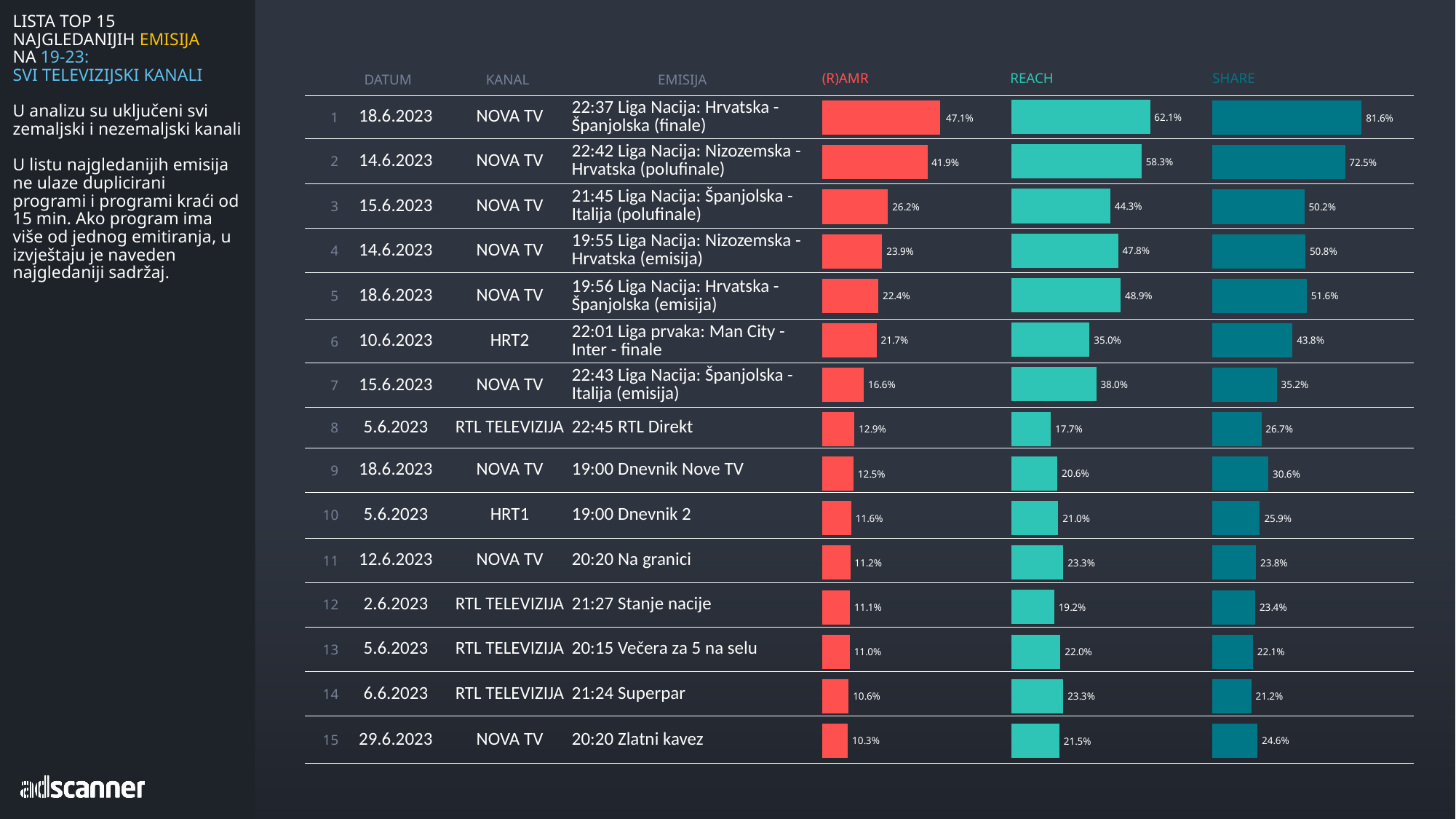
In the SHARE chart, what is the difference between 19:00 Dnevnik Nove TV and 19:00 Dnevnik 2? 4.7% In the REACH chart, which programme has the lowest value? 22:45 RTL Direkt In the (R)AMR chart, which programme has the lowest value? 20:20 Zlatni kavez In the (R)AMR chart, what is the value for 22:45 RTL Direkt? 12.9% What kind of chart is used for the REACH column? Bar chart In the SHARE chart, what is the value for 20:20 Zlatni kavez? 24.6% In the REACH chart, which is larger: 19:56 Liga Nacija: Hrvatska - Španjolska (emisija) or 19:55 Liga Nacija: Nizozemska - Hrvatska (emisija)? 19:56 Liga Nacija: Hrvatska - Španjolska (emisija) In the (R)AMR chart, what is the difference between 22:37 Liga Nacija: Hrvatska - Španjolska (finale) and 22:42 Liga Nacija: Nizozemska - Hrvatska (polufinale)? 5.2% In the SHARE chart, which programme has the highest value? 22:37 Liga Nacija: Hrvatska - Španjolska (finale) Do the (R)AMR values rise or fall going down the list from rank 1 to rank 15? Fall In the REACH chart, what is the value for 22:01 Liga prvaka: Man City - Inter - finale? 35.0% How many programmes are listed in the (R)AMR chart? 15